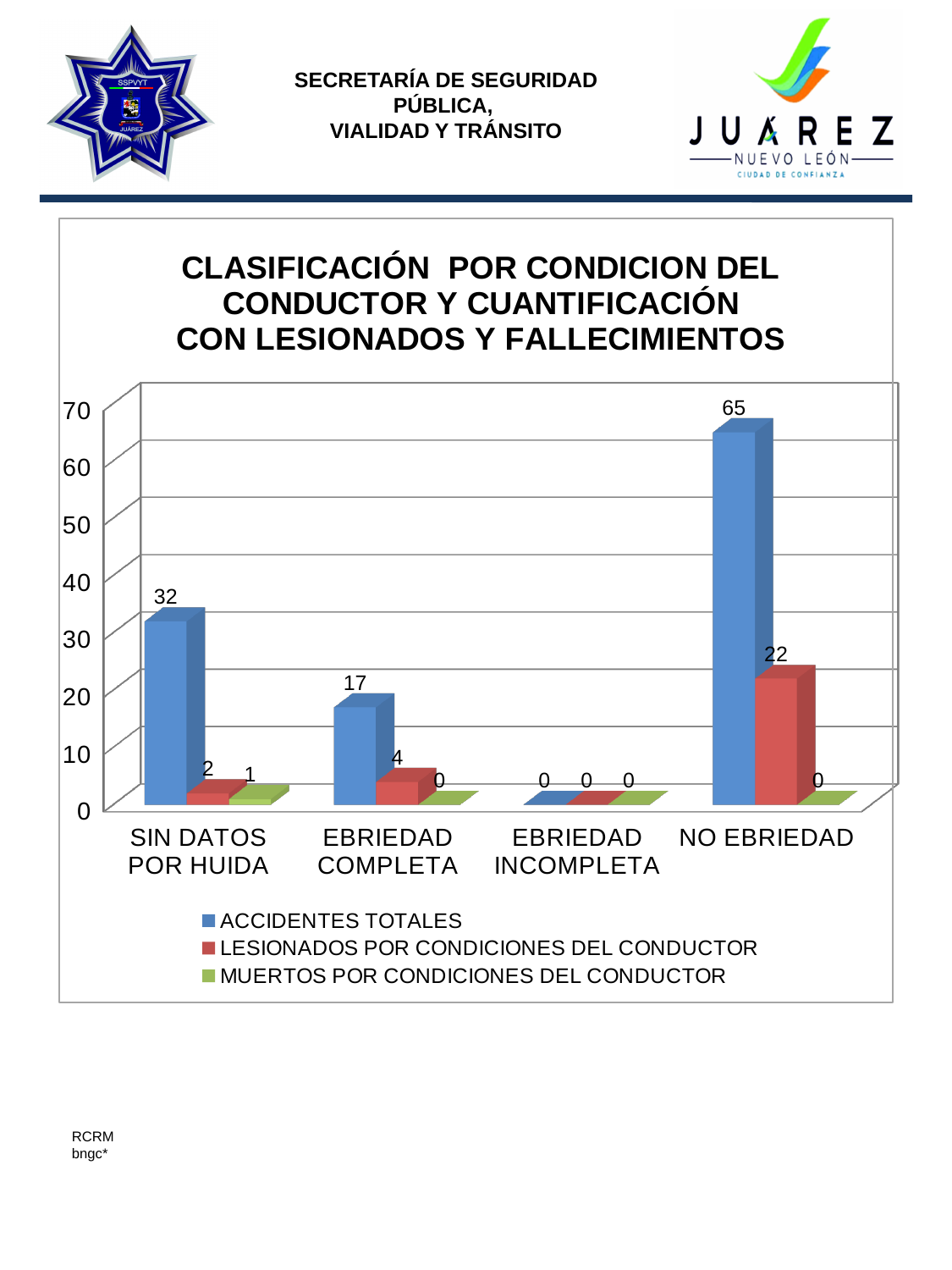
What colour represents the ACCIDENTES TOTALES series? blue What kind of chart is shown on the slide? bar chart What is the value of ACCIDENTES TOTALES for NO EBRIEDAD? 65 Which category has the highest value for ACCIDENTES TOTALES? NO EBRIEDAD Is the value of ACCIDENTES TOTALES for EBRIEDAD COMPLETA greater or less than 20? less What is the difference between ACCIDENTES TOTALES for NO EBRIEDAD and for SIN DATOS POR HUIDA? 33 Which category has the lowest value for ACCIDENTES TOTALES? EBRIEDAD INCOMPLETA What is the value of MUERTOS POR CONDICIONES DEL CONDUCTOR for SIN DATOS POR HUIDA? 1 How many categories are shown on the x axis? 4 What is the value of LESIONADOS POR CONDICIONES DEL CONDUCTOR for EBRIEDAD COMPLETA? 4 Which is larger: LESIONADOS POR CONDICIONES DEL CONDUCTOR for NO EBRIEDAD or for EBRIEDAD COMPLETA? NO EBRIEDAD How many series does the legend list? 3